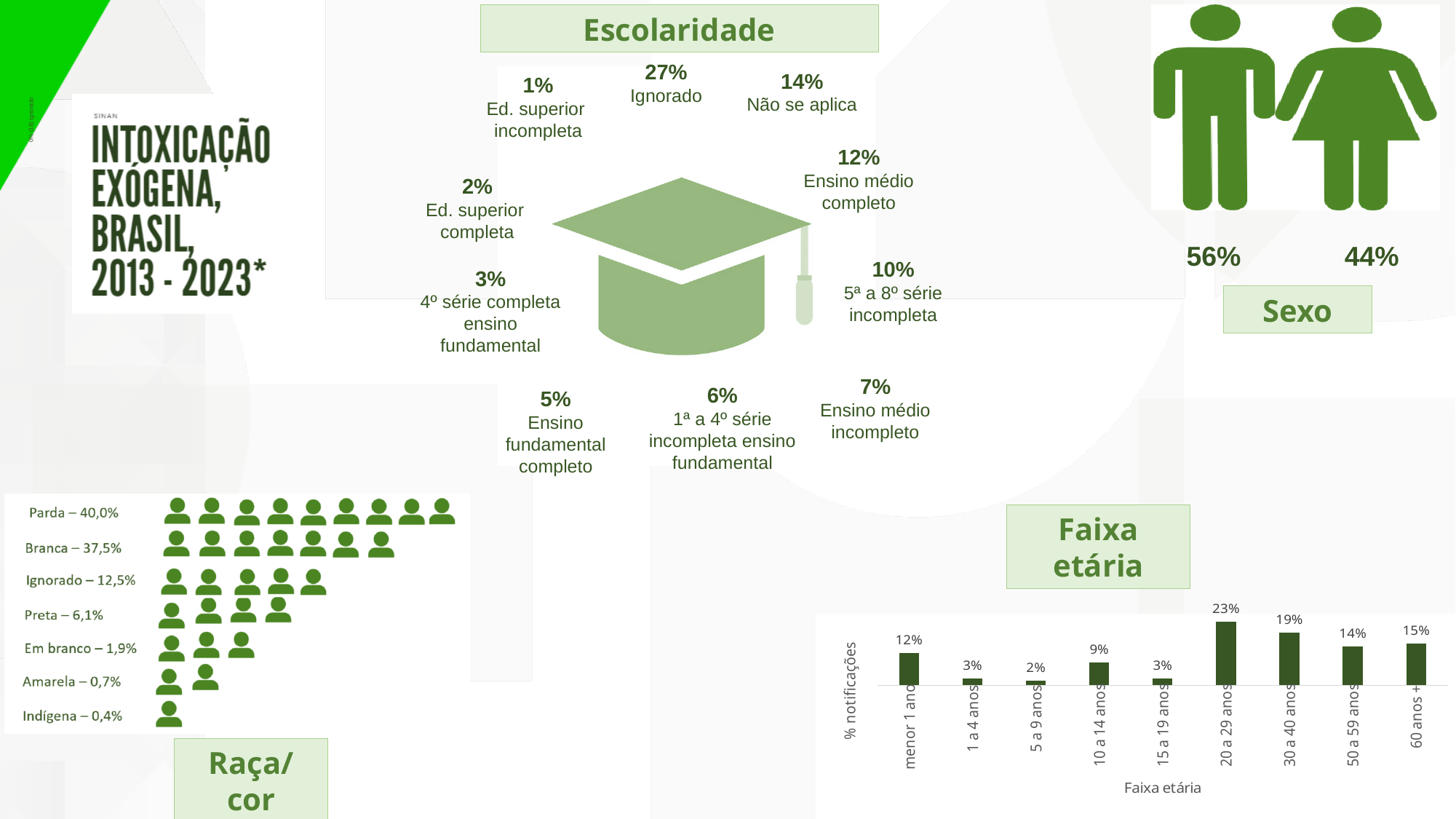
What is the label of the vertical axis in the Faixa etária bar chart? % notificações In the Faixa etária bar chart, what is the difference between the values for 20 a 29 anos and 30 a 40 anos? 4% In the Faixa etária bar chart, which is larger, the value for menor 1 ano or the value for 10 a 14 anos? menor 1 ano In the Faixa etária bar chart, which age group has the highest value? 20 a 29 anos What kind of chart is the Faixa etária chart? bar chart In the Faixa etária bar chart, which age group has the lowest value? 5 a 9 anos In the Faixa etária bar chart, which is larger, the value for 50 a 59 anos or the value for 60 anos +? 60 anos + How many age groups are shown in the Faixa etária bar chart? 9 In the Faixa etária bar chart, what is the value for menor 1 ano? 12% In the Faixa etária bar chart, what is the value for 60 anos +? 15% In the Faixa etária bar chart, what is the value for 20 a 29 anos? 23% In the Faixa etária bar chart, what is the value for 10 a 14 anos? 9%